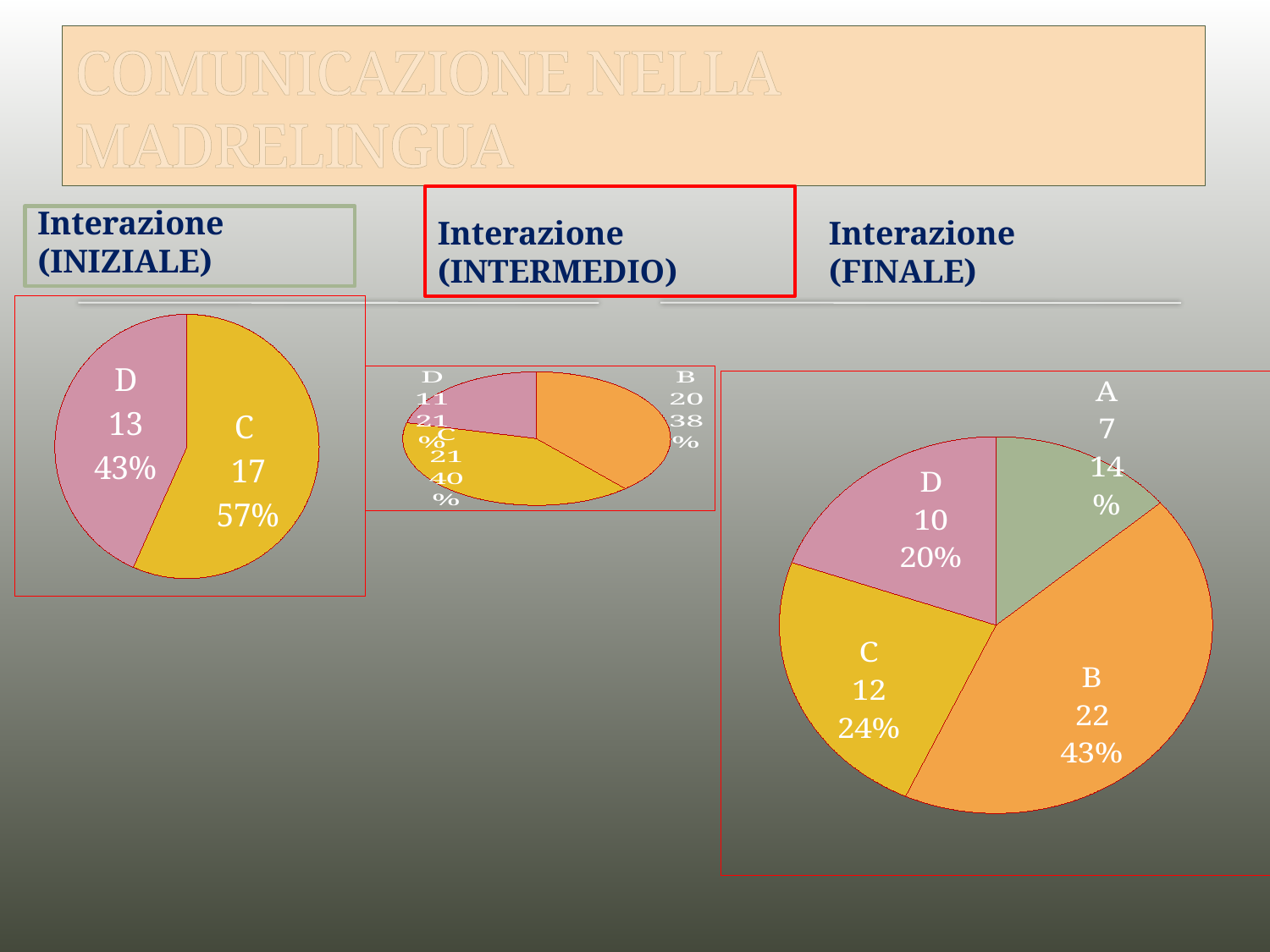
In the Interazione (FINALE) pie chart, what value is shown for category B? 22 In the Interazione (INIZIALE) pie chart, which category has the larger value, C or D? C In the Interazione (FINALE) pie chart, what is the difference between the values for B and C? 10 In the Interazione (FINALE) pie chart, which category has the largest value? B What type of chart is used for Interazione (FINALE)? Pie chart In the Interazione (INTERMEDIO) pie chart, what value is shown for category B? 20 In the Interazione (INIZIALE) pie chart, what is the difference between the values for C and D? 4 In the Interazione (INIZIALE) pie chart, what percentage share does category D have? 43% In the Interazione (INTERMEDIO) pie chart, which category has the smallest value? D In the Interazione (FINALE) pie chart, what percentage share does category A have? 14% How many slices does the Interazione (INIZIALE) pie chart have? 2 In the Interazione (INIZIALE) pie chart, what value is shown for category C? 17